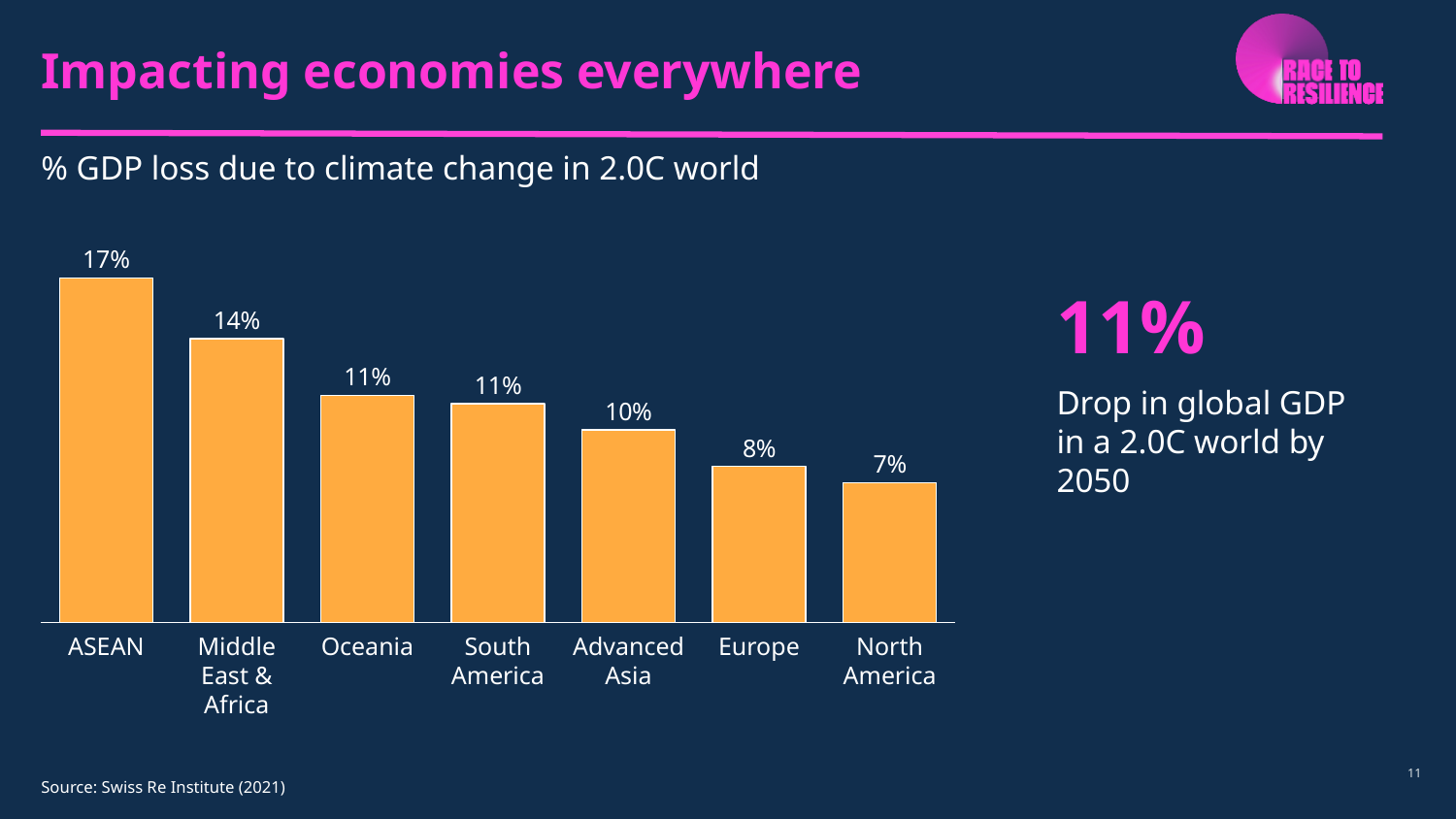
Do the values rise or fall from left to right across the chart? Fall Which has a larger % GDP loss, Oceania or Advanced Asia? Oceania How many regions are shown in the chart? 7 Which region has the lowest % GDP loss in the chart? North America What is the % GDP loss shown for Europe? 8% What is the difference in % GDP loss between ASEAN and North America? 10% What is the % GDP loss shown for ASEAN? 17% What is the % GDP loss shown for Advanced Asia? 10% What is the difference in % GDP loss between Middle East & Africa and Europe? 6% Which region has the highest % GDP loss in the chart? ASEAN What is the % GDP loss shown for Middle East & Africa? 14% What kind of chart is shown on the slide? Bar chart